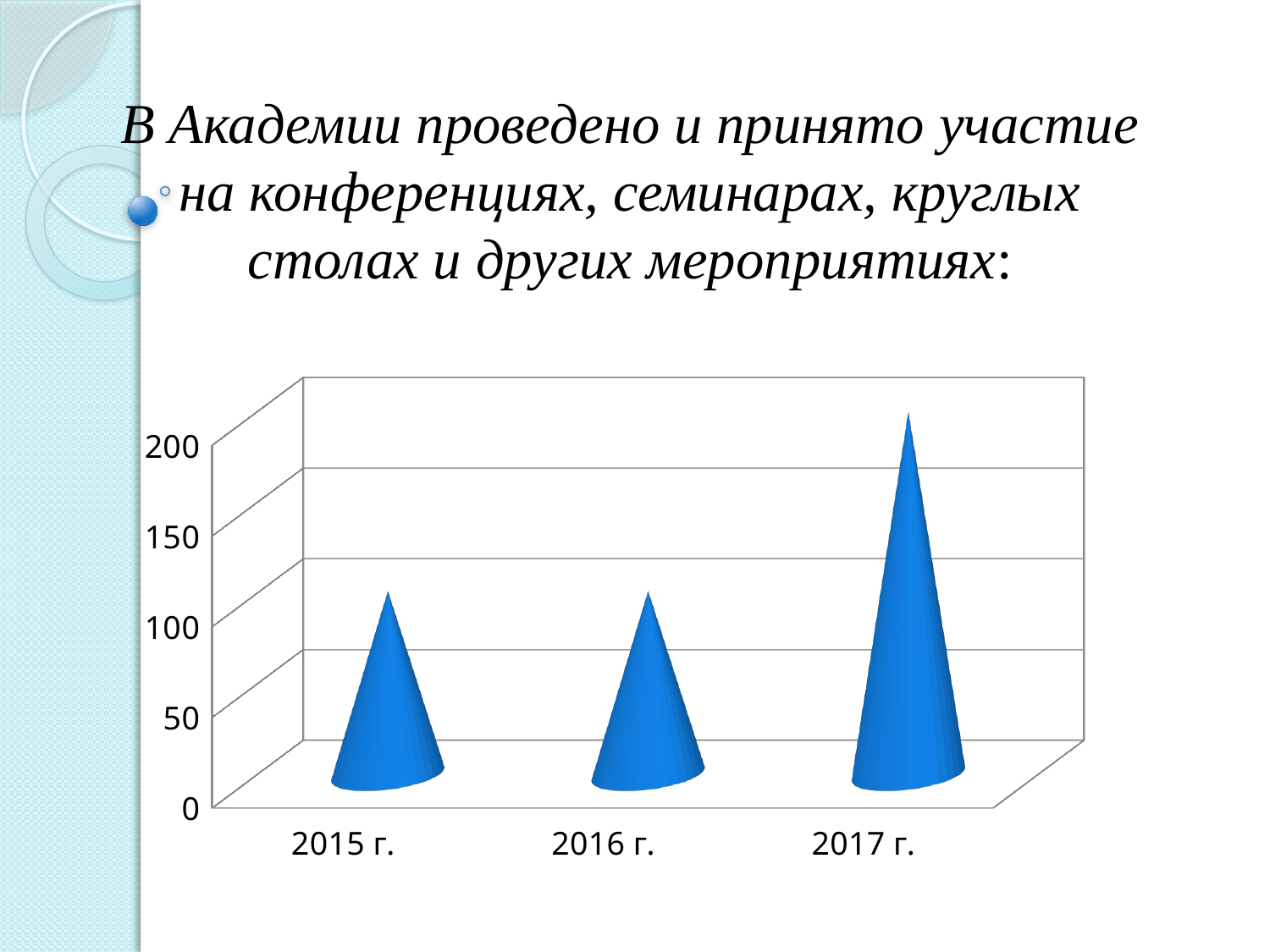
Is the value for 2015 г. greater or less than 150? less Is the value for 2016 г. greater or less than 50? greater Which year has the highest value in the chart? 2017 г. Is the value for 2017 г. greater or less than 150? greater Which is larger, the value for 2016 г. or the value for 2017 г.? 2017 г. Which is larger, the value for 2015 г. or the value for 2017 г.? 2017 г. What is the highest value labelled on the vertical axis of the chart? 200 How many categories are shown on the x axis of the chart? 3 What kind of chart is shown on the slide? bar chart Do the values rise or fall from 2015 г. to 2017 г.? rise